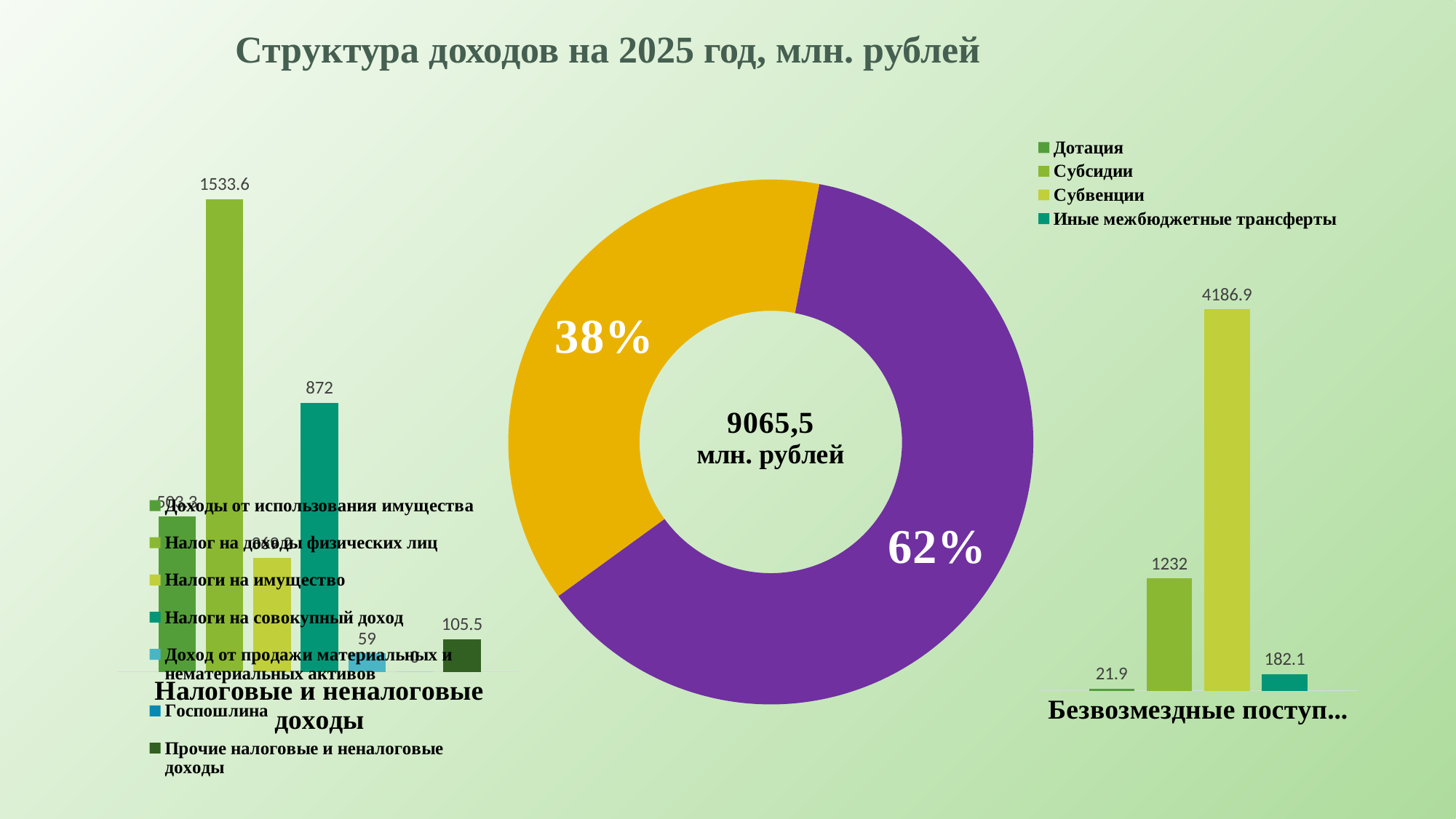
What total is printed in the centre of the donut chart? 9065,5 млн. рублей What kind of chart is the chart titled 'Налоговые и неналоговые доходы'? bar chart In the donut chart in the centre of the slide, what is the larger share shown? 62% How many series does the legend of the chart titled 'Безвозмездные поступ...' list? 4 In the chart titled 'Безвозмездные поступ...', which series has the lowest value? Дотация In the chart titled 'Налоговые и неналоговые доходы', what is the value for Налог на доходы физических лиц? 1533.6 In the chart titled 'Безвозмездные поступ...', what is the value for Дотация? 21.9 In the chart titled 'Безвозмездные поступ...', what is the value for Субвенции? 4186.9 In the chart titled 'Налоговые и неналоговые доходы', what is the value for Налоги на совокупный доход? 872 In the chart titled 'Безвозмездные поступ...', what is the difference between Субсидии and Иные межбюджетные трансферты? 1049.9 In the chart titled 'Налоговые и неналоговые доходы', which is larger: Налоги на совокупный доход or Прочие налоговые и неналоговые доходы? Налоги на совокупный доход In the chart titled 'Безвозмездные поступ...', which series has the highest value? Субвенции